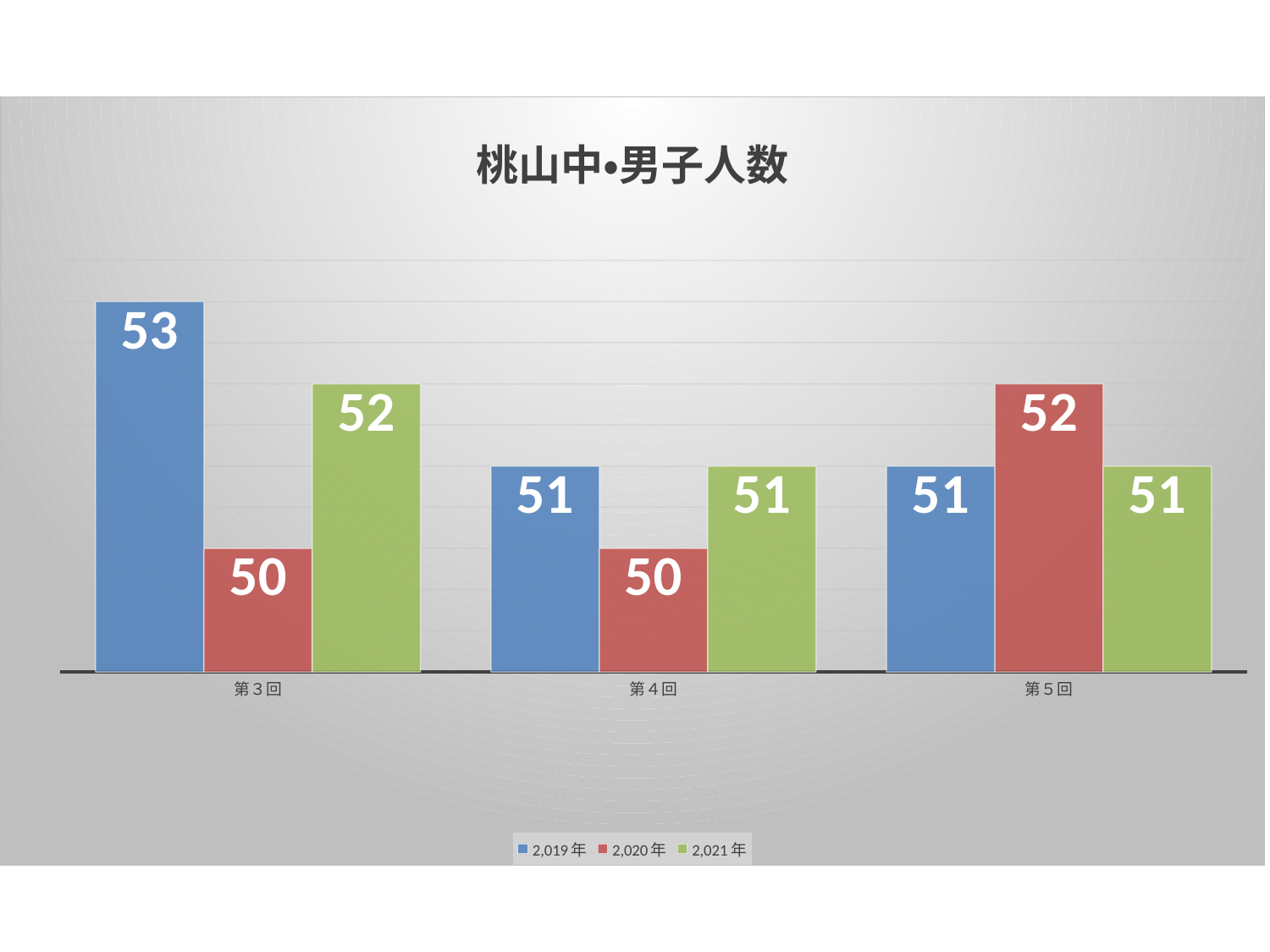
How many series does the legend list? 3 What is the value for 2,019年 at 第3回? 53 What kind of chart is shown on the slide? bar chart Which category has the highest value for the 2,019年 series? 第3回 Which is larger at 第5回: the 2,020年 value or the 2,021年 value? 2,020年 What is the value for 2,020年 at 第4回? 50 What is the title of the chart? 桃山中•男子人数 What is the value for 2,021年 at 第5回? 51 How many categories are shown on the x axis? 3 Which category has the lowest value for the 2,021年 series? 第4回 and 第5回 (tied at 51) What is the value for 2,020年 at 第5回? 52 What is the difference between the 2,019年 and 2,020年 values at 第3回? 3